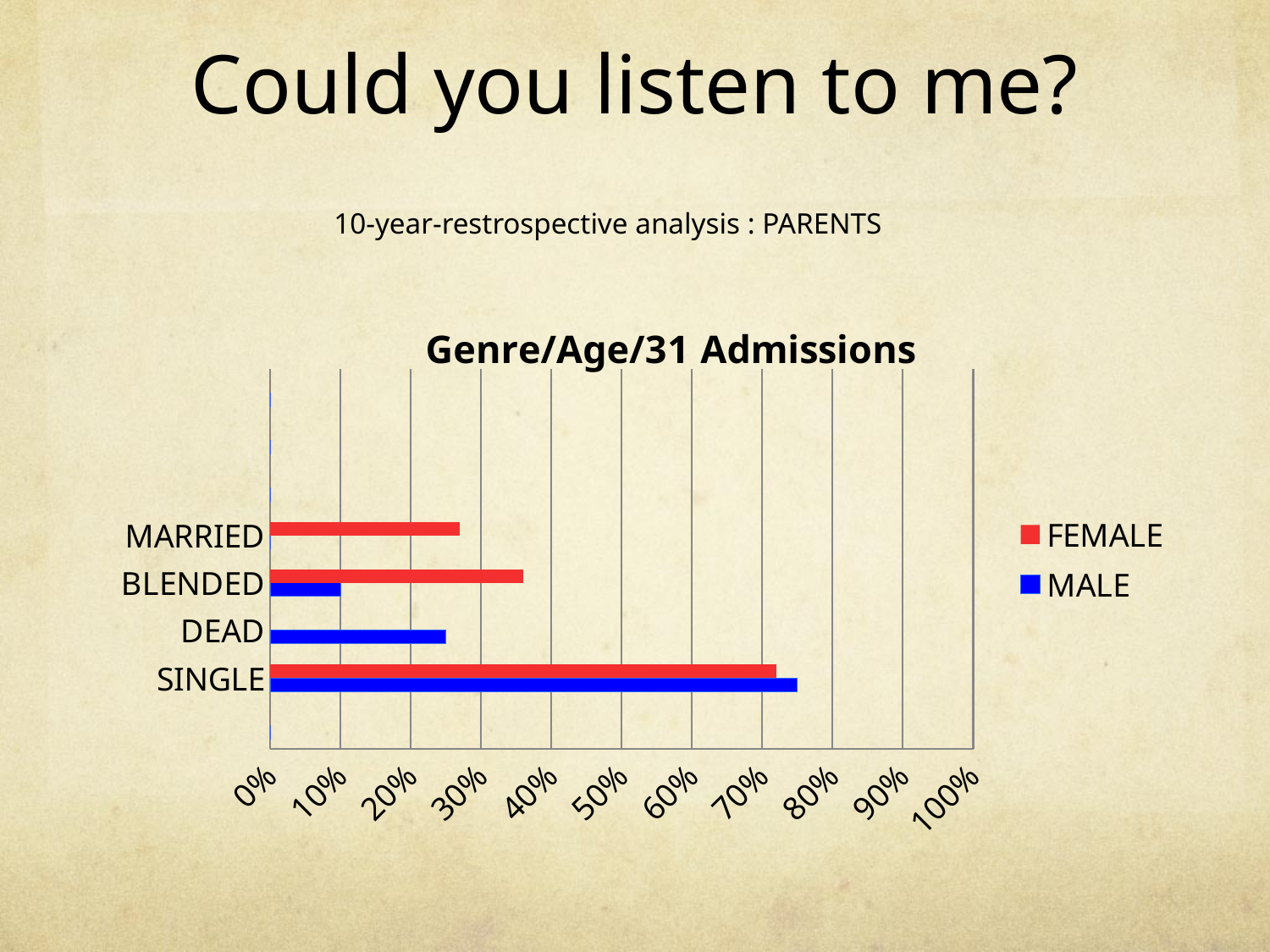
How many categories are shown on the chart's vertical axis? 4 Which colour represents the MALE series in the chart? blue Is the MALE value for DEAD greater or less than 20%? greater Which category has the highest FEMALE value? SINGLE Is the FEMALE value for BLENDED greater or less than 30%? greater Is the MALE value for SINGLE greater or less than 80%? less What kind of chart is shown on the slide? bar chart How many series does the chart legend list? 2 What is the title of the chart? Genre/Age/31 Admissions For BLENDED, which series has the larger value, FEMALE or MALE? FEMALE Which category has the highest MALE value? SINGLE